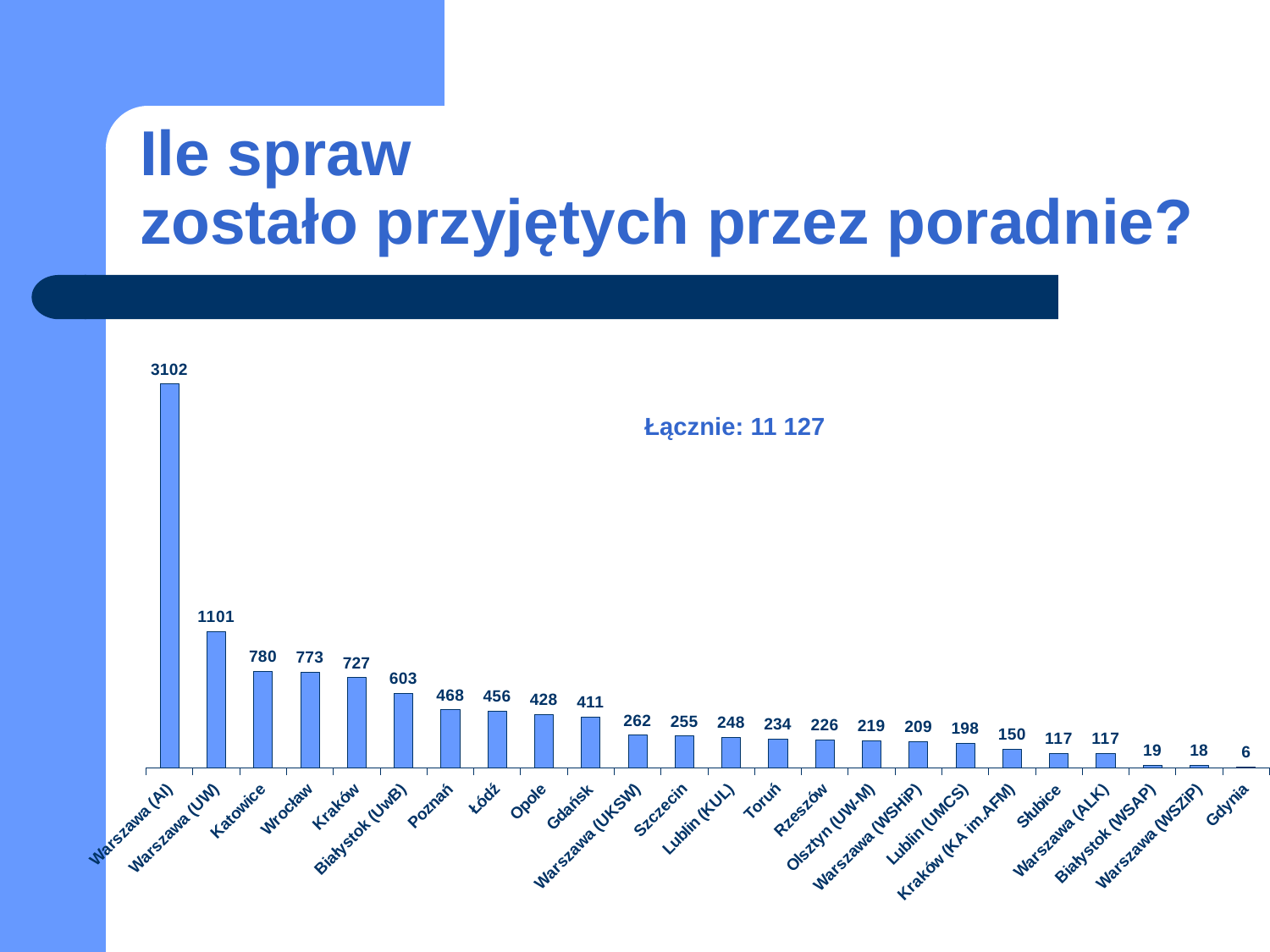
What kind of chart is shown on the slide? Bar chart How many cases does the chart show for Warszawa (UW)? 1101 What is the difference between the values for Katowice and Kraków? 53 What value is shown for Poznań? 468 How many categories are plotted on the chart? 24 Which category has the highest value on the chart? Warszawa (AI) What value is shown for Lublin (KUL)? 248 What is the difference between the values for Warszawa (AI) and Warszawa (UW)? 2001 Which is larger, the value for Opole or the value for Gdańsk? Opole Which category has the lowest value on the chart? Gdynia What total is stated in the text label on the chart (Łącznie)? 11 127 Which is larger, the value for Szczecin or the value for Toruń? Szczecin